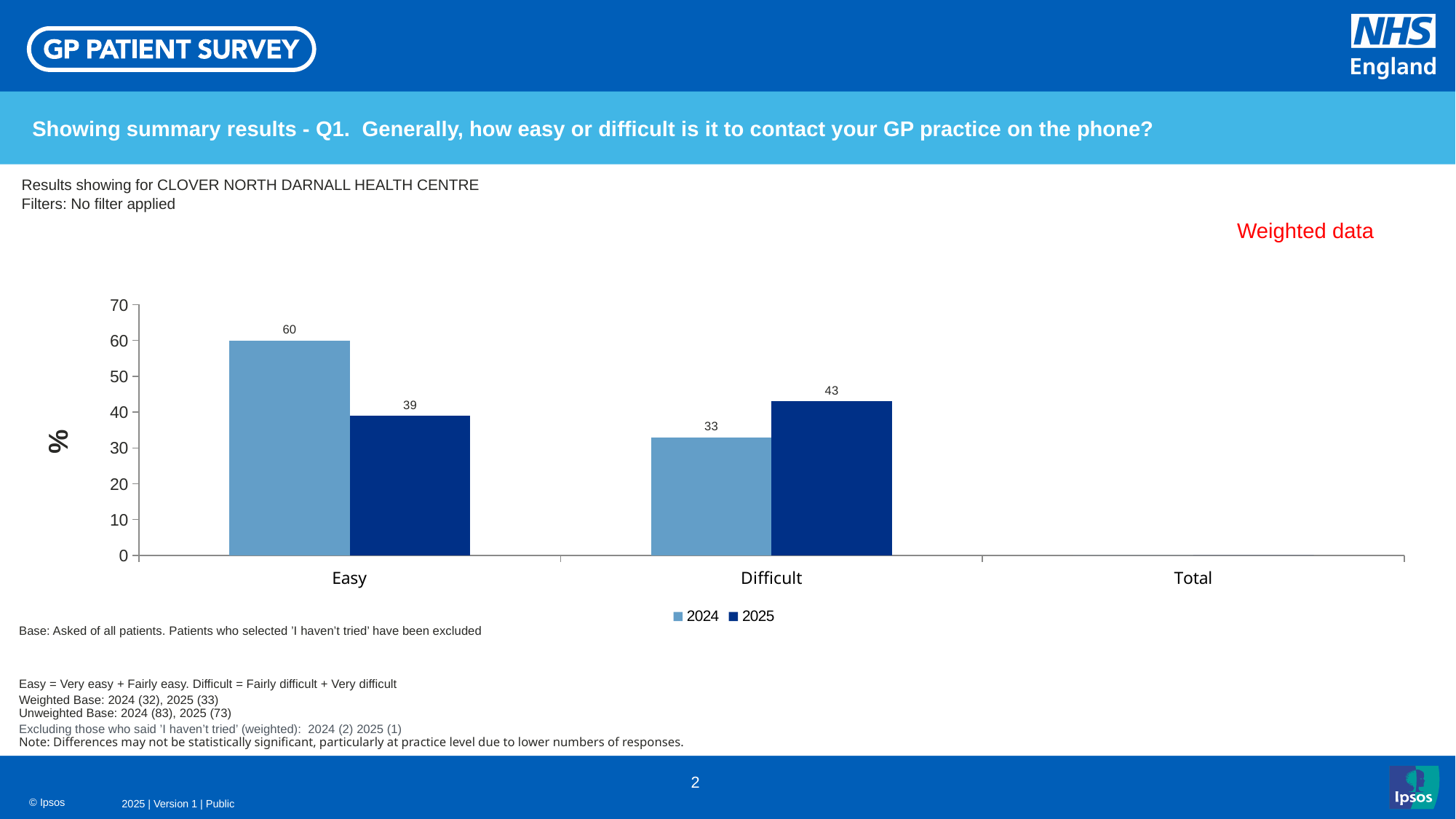
Which is larger for Difficult: the 2024 value or the 2025 value? 2025 What is the value for Difficult in 2024? 33 What is the label on the vertical axis of the chart? % How many series does the legend list? 2 Which category has the highest value in the 2024 series? Easy What is the value for Difficult in 2025? 43 What is the value for Easy in 2024? 60 What is the value for Easy in 2025? 39 What kind of chart is shown on the slide? Bar chart What is the difference between the 2024 and 2025 values for Easy? 21 Which category has the lowest value in the 2025 series? Easy What is the difference between the 2025 and 2024 values for Difficult? 10